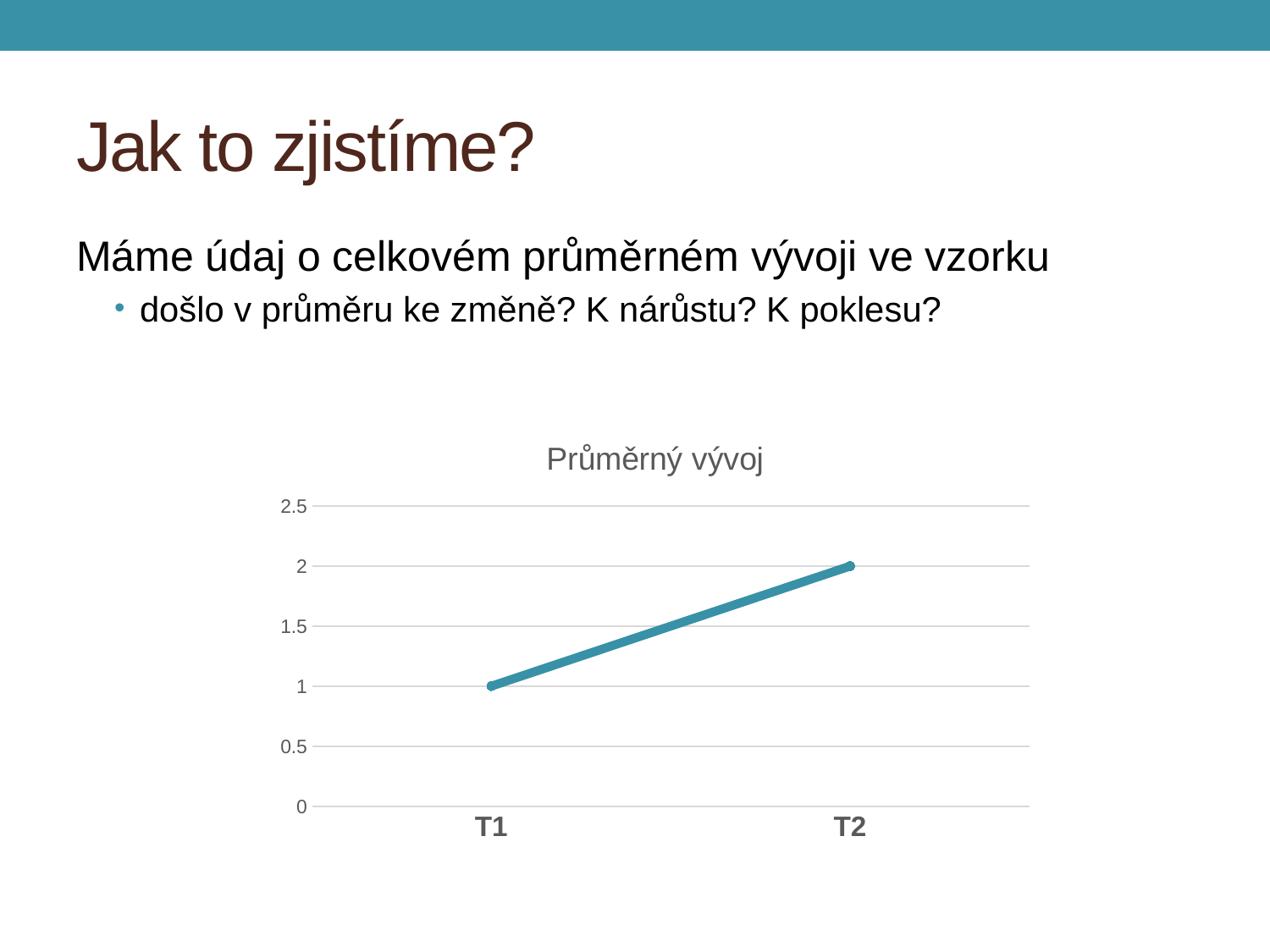
Is the value at T2 greater or less than 1.5? greater Does the line rise or fall from T1 to T2? rise Which point has the higher value, T1 or T2? T2 Is the value at T2 larger than the value at T1? yes What is the value at T1 in the chart? 1 What is the highest value shown on the y axis of the chart? 2.5 How many points are plotted on the line in the chart? 2 Which point has the lower value, T1 or T2? T1 What is the title of the chart? Průměrný vývoj What is the value at T2 in the chart? 2 What is the difference between the value at T2 and the value at T1? 1 What kind of chart is shown on the slide? line chart